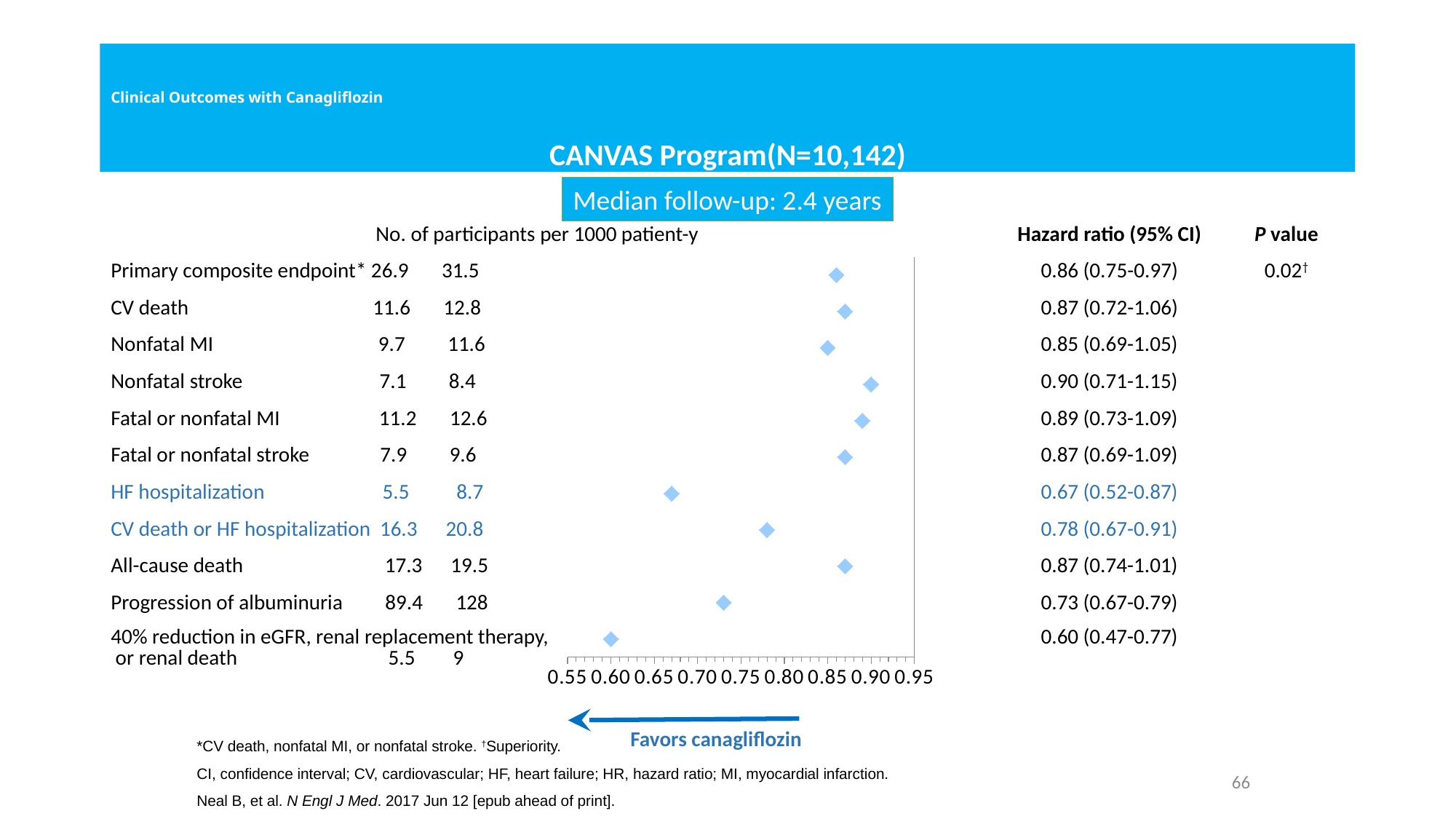
What is the hazard ratio plotted for the Primary composite endpoint? 0.86 How many outcomes are plotted as points on the chart? 11 What is the difference between the hazard ratio for CV death and the hazard ratio for HF hospitalization? 0.20 Which outcome has the lowest hazard ratio on the chart? 40% reduction in eGFR, renal replacement therapy, or renal death Which has the lower hazard ratio: HF hospitalization or CV death or HF hospitalization? HF hospitalization Which outcome has the highest hazard ratio on the chart? Nonfatal stroke What is the hazard ratio plotted for HF hospitalization? 0.67 What kind of chart is used to display the hazard ratios? scatter chart What does the arrow below the x axis indicate? Favors canagliflozin Is the hazard ratio for Nonfatal stroke greater or less than 0.85? greater What is the hazard ratio plotted for Progression of albuminuria? 0.73 Is the hazard ratio for Progression of albuminuria greater or less than 0.80? less